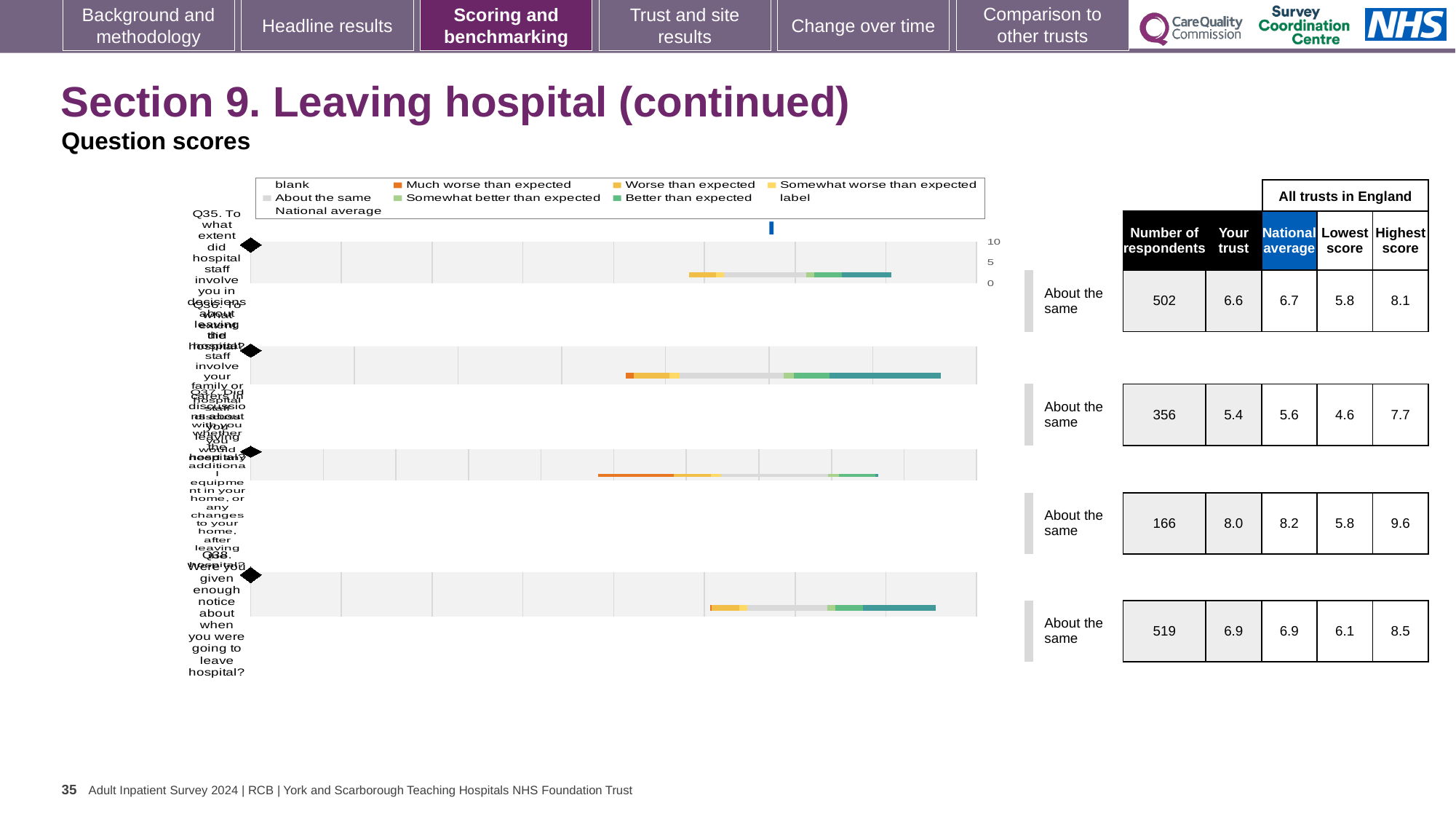
What kind of chart is used to show the question scores on this slide? bar chart Which chart (by position from the top) has the lowest 'Your trust' score? the second chart (5.4) For Q35 (the first chart), what is the difference between the highest score and the lowest score among all trusts in England? 2.3 What benchmark category is shown next to each of the four charts? About the same What is the highest score among all trusts in England for the third chart from the top? 9.6 For Q38 (the bottom chart), is the 'Your trust' score higher than, lower than, or the same as the national average? the same What is the subtitle shown above the charts on this slide? Question scores What is the 'Your trust' score for Q35 (the first chart from the top)? 6.6 For Q35 (the first chart), what is the difference between the national average and the 'Your trust' score? 0.1 How many question charts (bars) are shown on the slide? 4 Which chart (by position from the top) has the highest 'Your trust' score? the third chart (8.0) How many respondents are listed for Q38 (the bottom chart)? 519